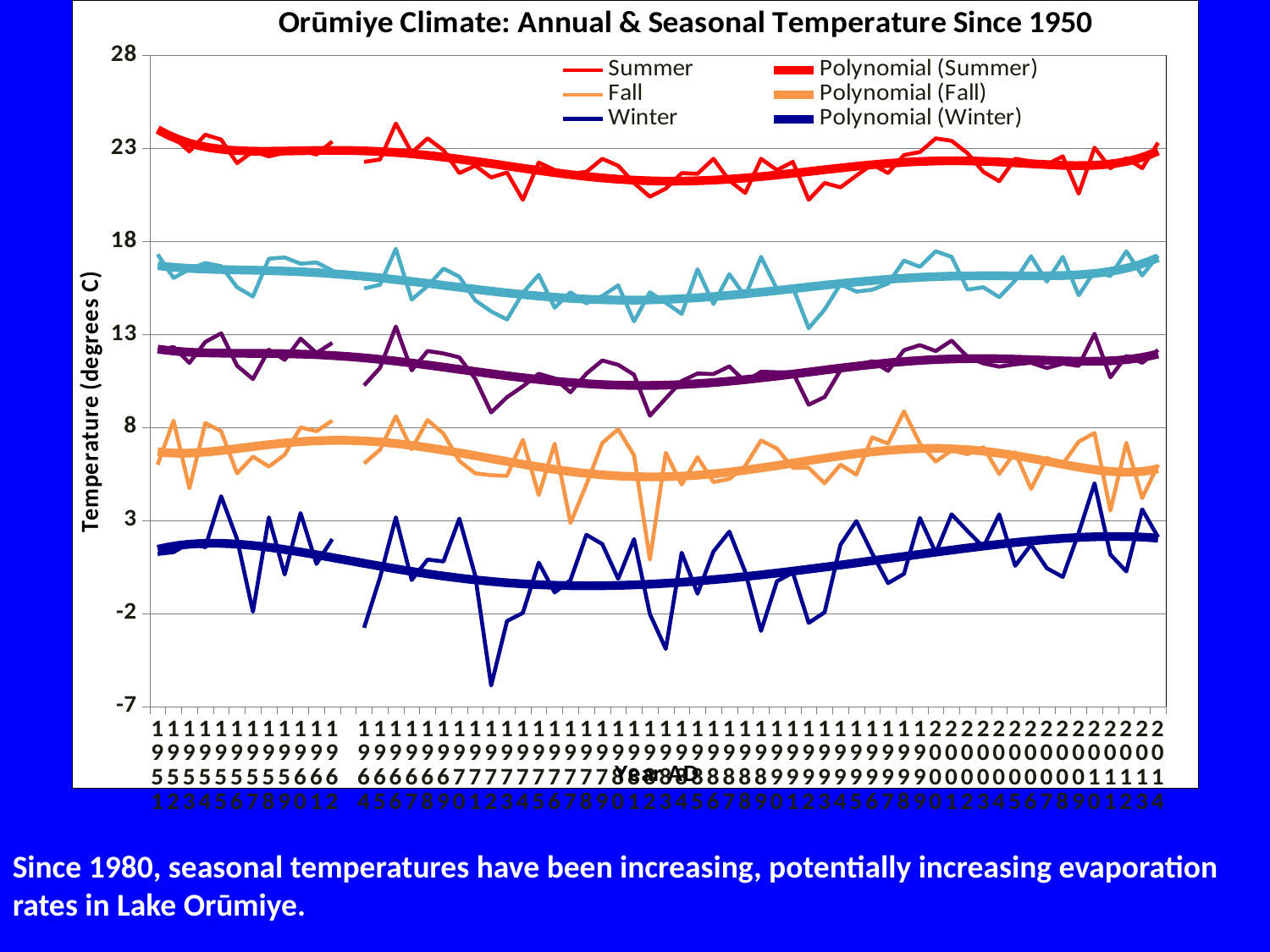
Are the Summer temperature values greater or less than 18 degrees C across the chart? greater Which of the labelled seasonal series has the highest temperatures throughout the chart? Summer Are the Fall temperature values greater or less than 13 degrees C across the chart? less Which series has higher values, Fall or Winter? Fall Which of the labelled seasonal series has the lowest temperatures throughout the chart? Winter What kind of chart is shown on the slide? Line chart What is the title of the chart? Orūmiye Climate: Annual & Seasonal Temperature Since 1950 Which series has higher values, Summer or Winter? Summer Does the Polynomial (Winter) trend line rise or fall between 1980 and 2010? rise Does the Polynomial (Summer) trend line rise or fall between 1950 and 1980? fall What is the label on the vertical axis of the chart? Temperature (degrees C) How many entries does the chart's legend list? 6